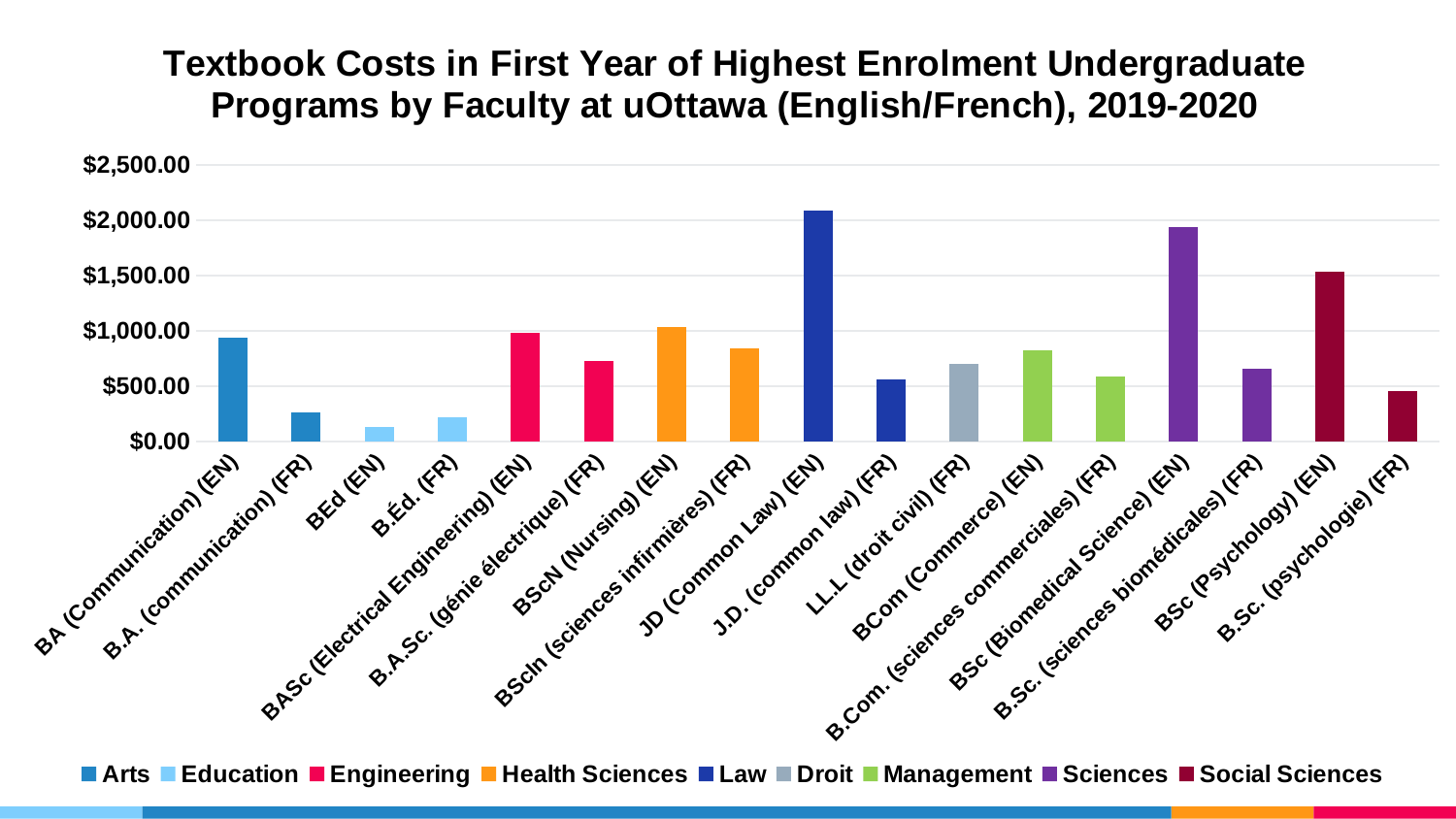
Which program has the highest textbook cost in the chart? JD (Common Law) (EN) How many faculties does the legend list? 9 Which program has the lowest textbook cost in the chart? BEd (EN) Which has the higher textbook cost: BASc (Electrical Engineering) (EN) or B.A.Sc. (génie électrique) (FR)? BASc (Electrical Engineering) (EN) Is the value for JD (Common Law) (EN) greater or less than $1,500.00? greater How many programs (bars) are shown in the chart? 17 Which has the higher textbook cost: BCom (Commerce) (EN) or B.Com. (sciences commerciales) (FR)? BCom (Commerce) (EN) Is the value for B.A. (communication) (FR) greater or less than $500.00? less Is the value for BSc (Biomedical Science) (EN) greater or less than $2,000.00? less What type of chart is shown on the slide? bar chart Which faculty in the legend is represented by the orange bars? Health Sciences